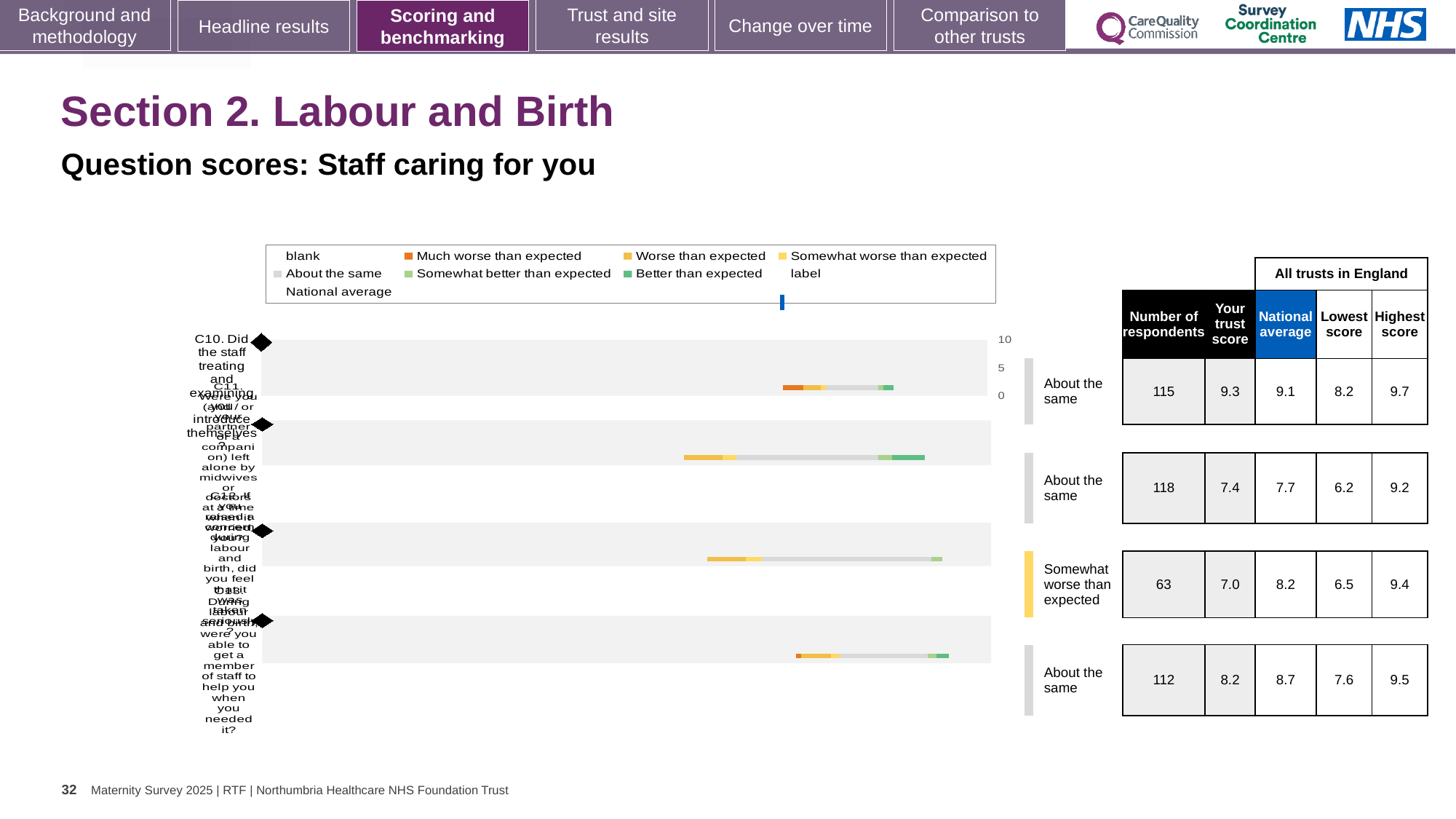
For the third question row, what is the difference between the national average and the trust score? 1.2 What is the highest score for the bottom (fourth) question row? 9.5 What is the national average for the third question row? 8.2 What is the number of respondents for the top (first) question row? 115 For the second question row, which is larger: the trust score or the national average? the national average How many question rows are plotted in the chart? 4 How many question rows are rated 'About the same'? 3 Which question row has the lowest number of respondents? the third row, 63 What kind of chart is shown on the slide? bar chart What benchmark category is shown for the third question row? Somewhat worse than expected Which question row has the highest trust score? the top (first) row, 9.3 What is the trust score for the second question row? 7.4